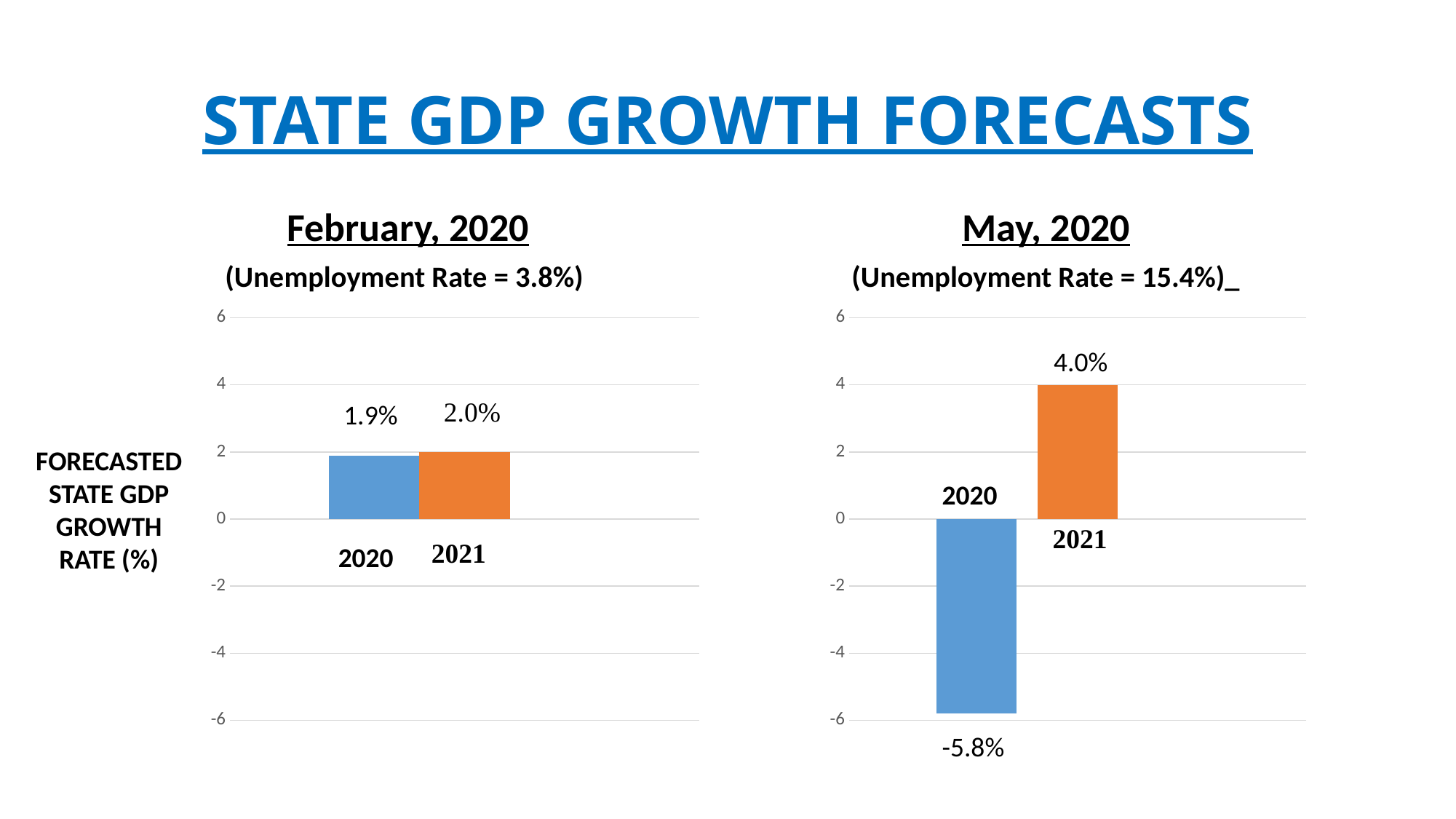
In the May, 2020 chart, what is the difference between the 2021 and 2020 forecasted growth rates? 9.8 percentage points In the February, 2020 chart, what is the forecasted state GDP growth rate for 2021? 2.0% In the May, 2020 chart, which year has the lowest forecasted growth rate? 2020 In the May, 2020 chart, which year has the highest forecasted growth rate? 2021 In the May, 2020 chart, what is the forecasted state GDP growth rate for 2021? 4.0% In the February, 2020 chart, what is the forecasted state GDP growth rate for 2020? 1.9% In the May, 2020 chart, what is the forecasted state GDP growth rate for 2020? -5.8% What kind of chart is the May, 2020 chart? Bar chart How many bars are plotted in the February, 2020 chart? 2 In the February, 2020 chart, what is the difference between the 2021 and 2020 forecasted growth rates? 0.1 percentage points What unemployment rate is stated in the subtitle of the May, 2020 chart? 15.4% In the May, 2020 chart, is the value for 2020 greater or less than -4? less